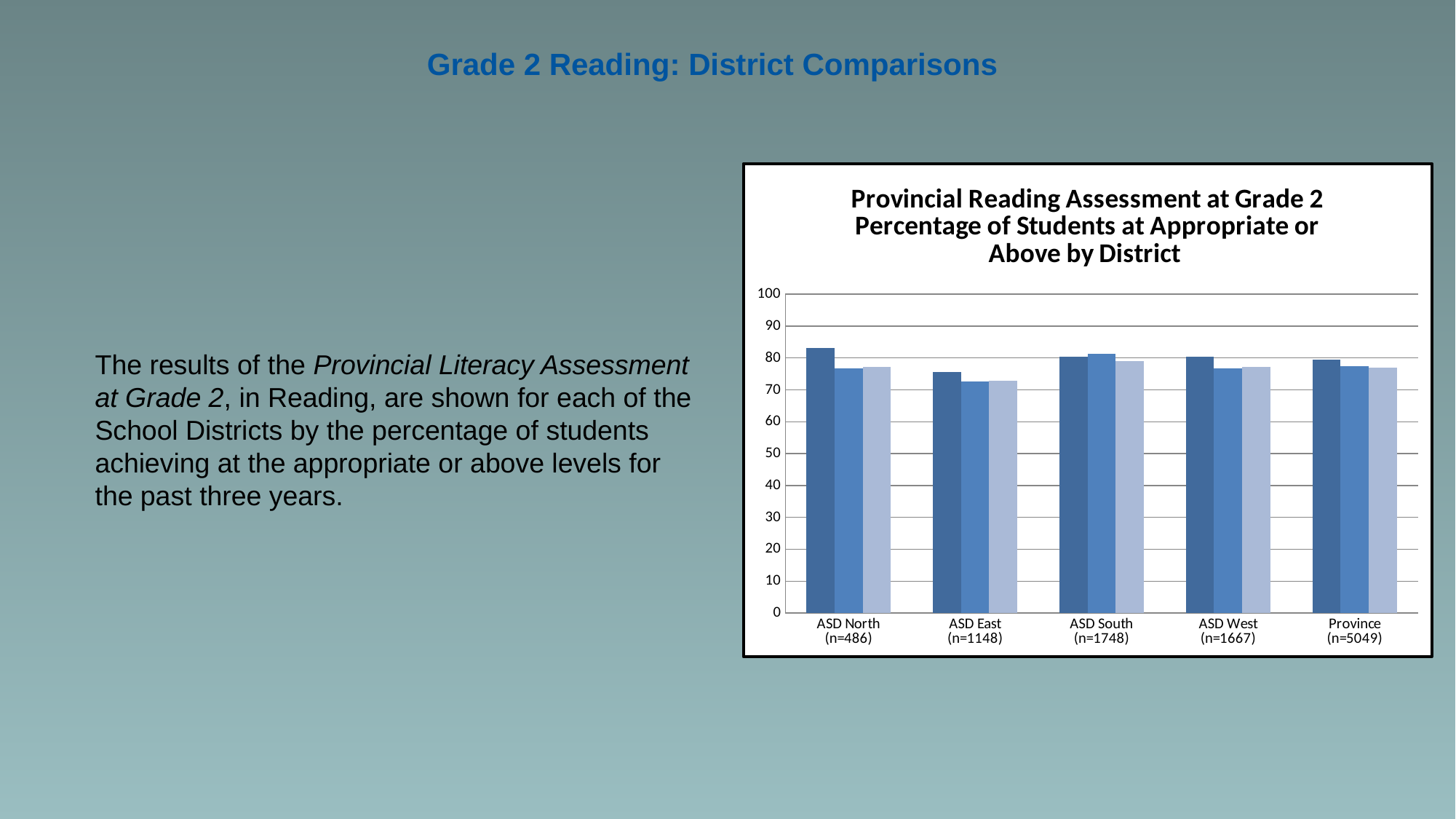
Is the value of the first (darkest) bar for ASD East greater or less than 70? greater What is the sample size (n) shown for ASD South on the x axis? n=1748 How many bars are plotted for each district in the chart? 3 Are the bars for ASD East greater or less than 80? less What is the maximum value shown on the y axis of the chart? 100 Which district has the lowest bars in the chart? ASD East Which is larger: the first (darkest) bar for ASD North or the first (darkest) bar for ASD East? ASD North Which is larger: the middle bar for ASD South or the middle bar for ASD East? ASD South Is the value of the first (darkest) bar for ASD North greater or less than 80? greater What kind of chart is shown on the slide? bar chart How many districts (categories) are shown on the x axis of the chart? 5